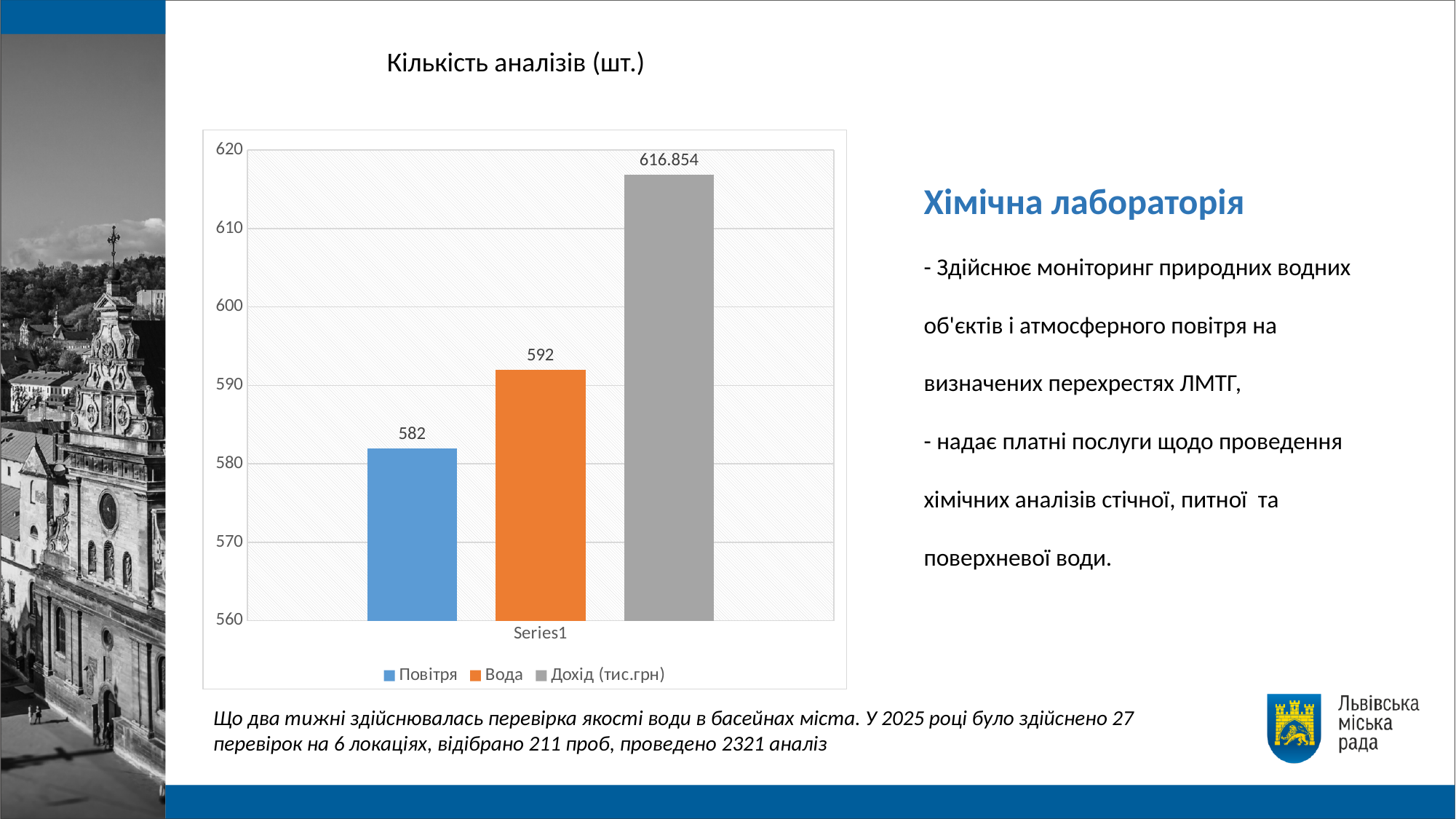
What is the difference between the values for Вода and Повітря? 10 Which is larger, the value for Вода or the value for Повітря? Вода Is the value for Дохід (тис.грн) greater or less than 610? greater What is the value for Вода? 592 What is the value for Дохід (тис.грн)? 616.854 What colour is the bar for Вода? orange Which series has the lowest value? Повітря What is the value for Повітря? 582 Which series has the highest value? Дохід (тис.грн) What is the title of the chart? Кількість аналізів (шт.) How many series does the legend list? 3 What kind of chart is shown on the slide? bar chart